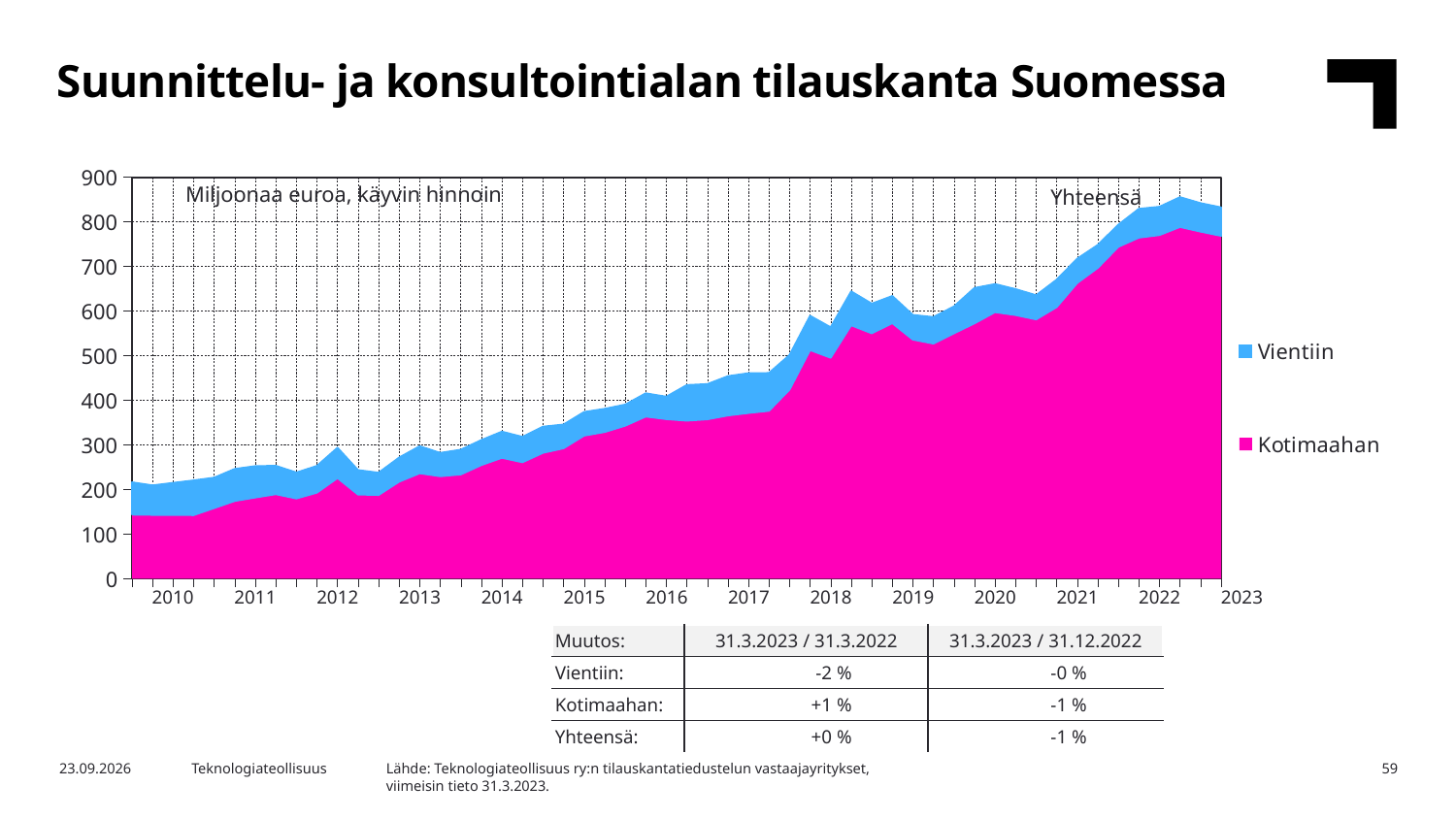
How many year labels are shown on the x axis? 14 Which two series are listed in the chart legend? Vientiin and Kotimaahan Is the Kotimaahan value at the start of 2015 greater or less than 400? less Is the Kotimaahan value at the start of 2010 greater or less than 200? less Which series is larger throughout the chart, Vientiin or Kotimaahan? Kotimaahan Is the total (Yhteensä) value at the start of 2010 greater or less than 300? less What unit is stated in the label at the top left of the chart? Miljoonaa euroa, käyvin hinnoin According to the table below the chart, what is the change (Muutos) for Vientiin between 31.3.2022 and 31.3.2023? -2 % How many series does the chart legend list? 2 Does the total order backlog (Yhteensä) generally rise or fall from 2010 to 2023? Rise What kind of chart is shown on the slide? Stacked area chart